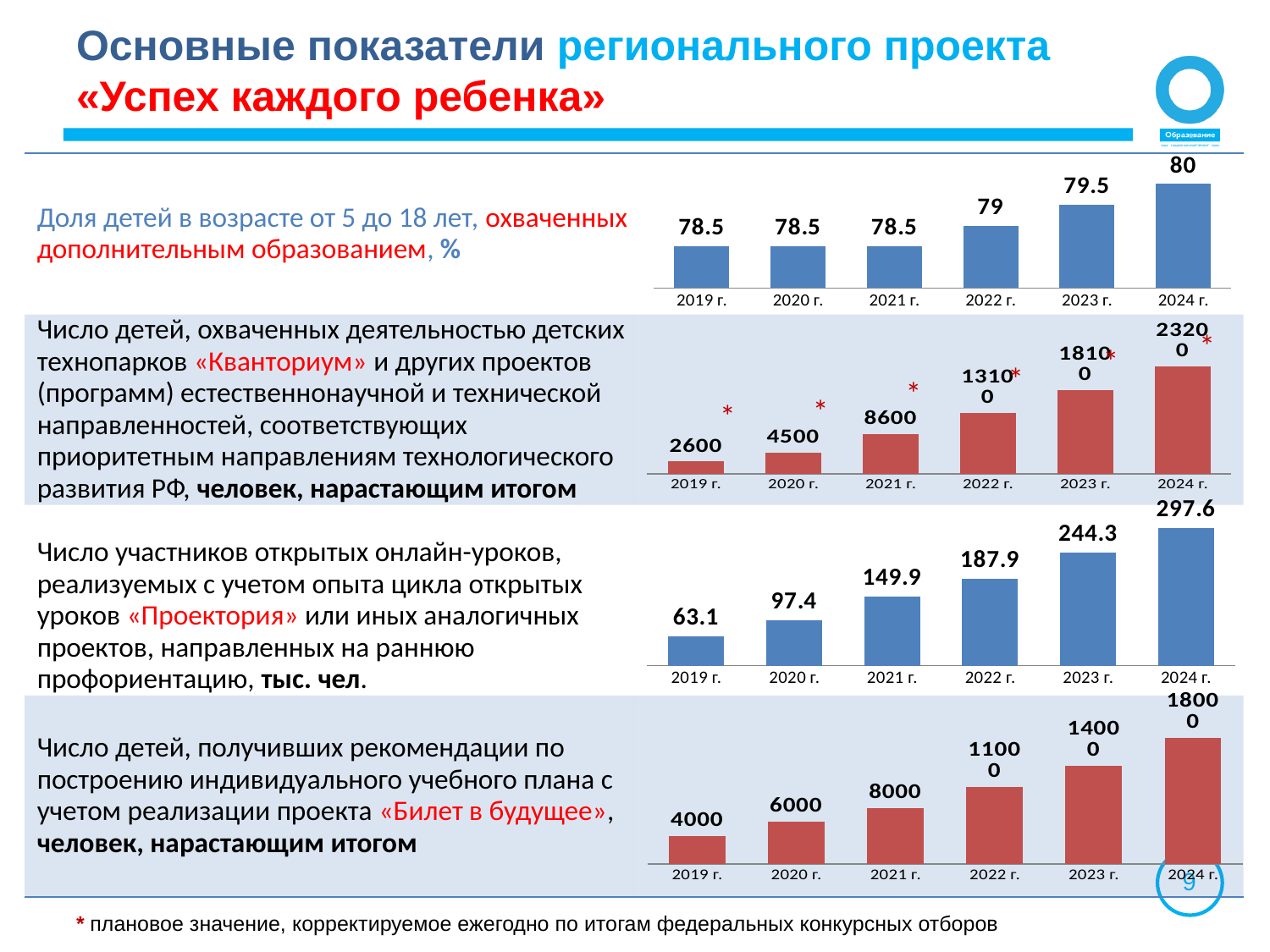
What type of chart is the bottom chart (children who received recommendations under «Билет в будущее»)? bar chart In the second chart from the top (children covered by «Кванториум» technoparks), what is the value for 2019 г.? 2600 In the second chart from the top (children covered by «Кванториум» technoparks), what is the value for 2021 г.? 8600 In the third chart from the top (participants of open online lessons «Проектория», тыс. чел.), what is the value for 2023 г.? 244.3 In the top chart (share of children covered by additional education, %), what is the difference between the 2024 г. and 2019 г. values? 1.5 In the top chart (share of children covered by additional education, %), which year has the highest value? 2024 г. In the top chart (share of children aged 5–18 covered by additional education, %), what is the value for 2022 г.? 79 In the third chart from the top (participants of open online lessons «Проектория», тыс. чел.), what is the difference between the 2021 г. and 2020 г. values? 52.5 In the bottom chart (children who received recommendations under «Билет в будущее»), what is the value for 2020 г.? 6000 In the third chart from the top (participants of open online lessons «Проектория», тыс. чел.), which year has the lowest value? 2019 г. In the second chart from the top (children covered by «Кванториум» technoparks), do the values rise or fall from 2019 г. to 2024 г.? rise In the top chart (share of children covered by additional education, %), how many years are plotted? 6